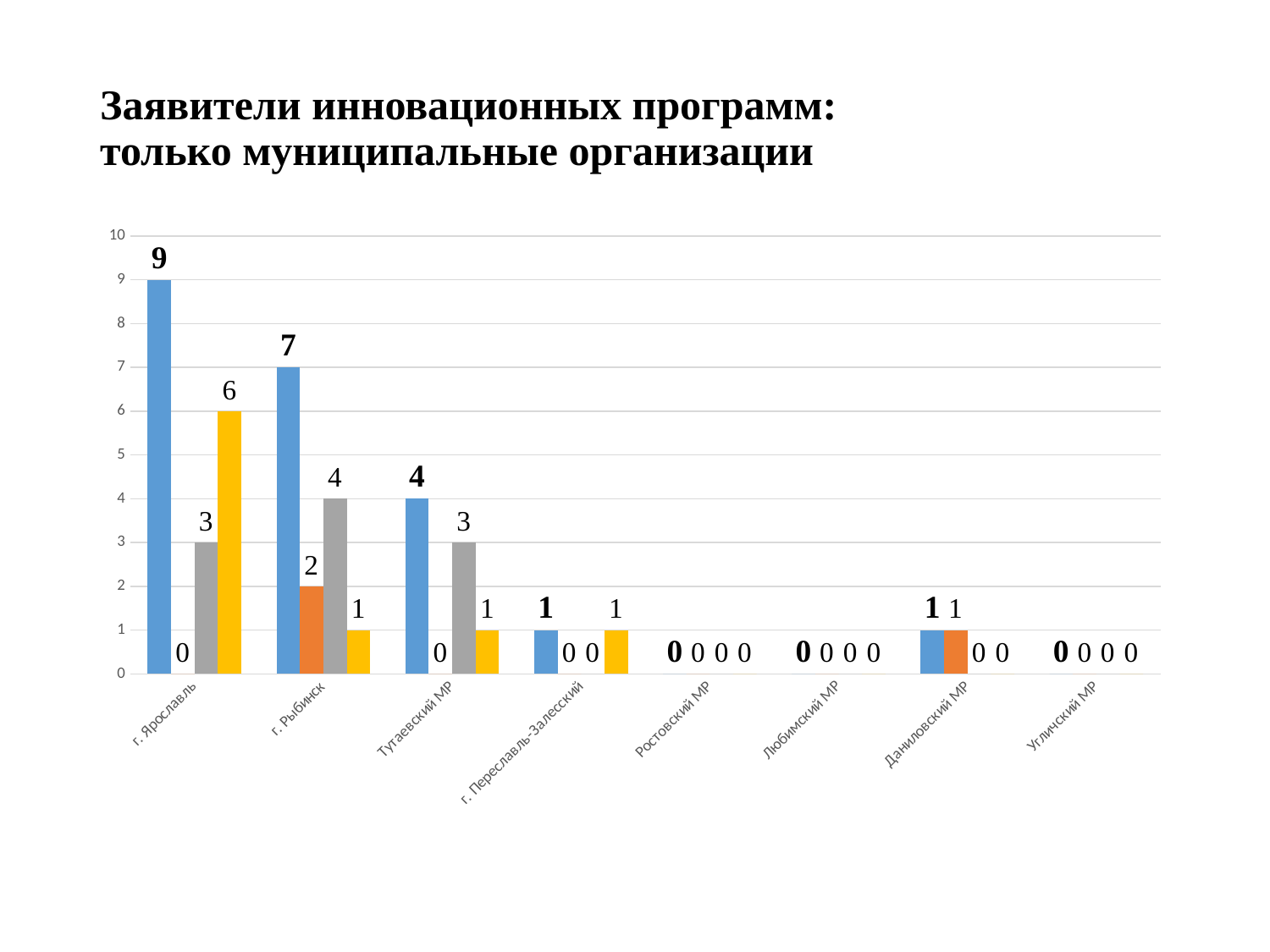
What is the value of the blue bar for Тутаевский МР? 4 What is the difference between the blue bar values for г. Ярославль and г. Рыбинск? 2 What is the title of the slide? Заявители инновационных программ: только муниципальные организации Which is larger: the yellow bar for г. Ярославль or the yellow bar for г. Рыбинск? г. Ярославль Is the blue bar for г. Рыбинск greater or less than 5? greater What is the value of the yellow bar for г. Ярославль? 6 Which category has the highest blue bar? г. Ярославль How many categories are shown on the x axis? 8 What type of chart is shown on the slide? bar chart What is the value of the grey bar for г. Рыбинск? 4 What is the value of the orange bar for г. Рыбинск? 2 What is the value of the blue bar for г. Ярославль? 9